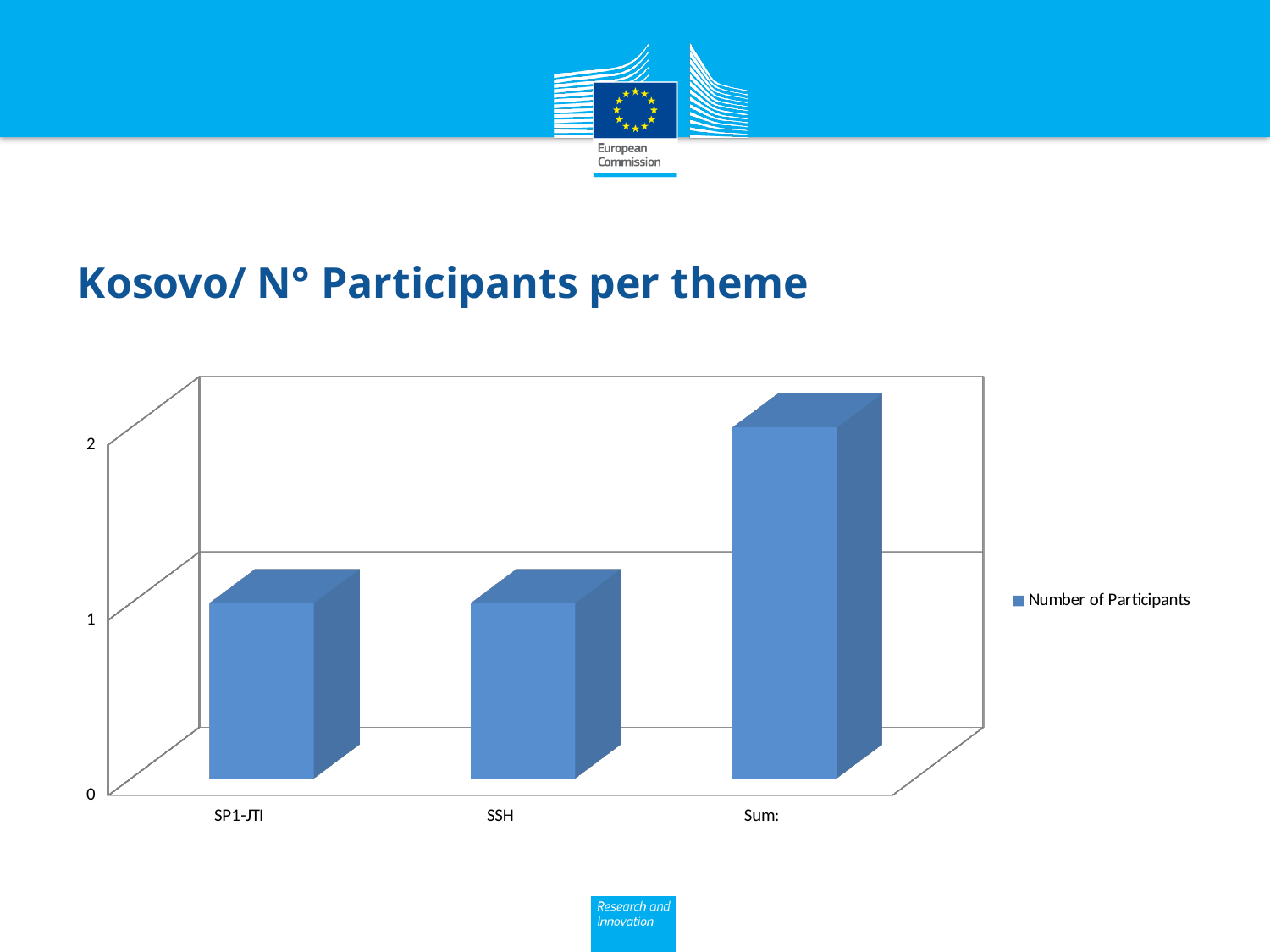
What type of chart is shown on the slide? bar chart What is the value shown for Sum:? 2 How many categories are shown on the x axis of the chart? 3 How many series does the legend list? 1 What is the number of participants for SP1-JTI? 1 What series name is shown in the legend? Number of Participants What is the title of the chart on the slide? Kosovo/ N° Participants per theme Which is larger, the value for Sum: or the value for SSH? Sum: Which category has the highest bar? Sum: What is the number of participants for SSH? 1 What is the difference between the value for Sum: and the value for SP1-JTI? 1 Is the value for Sum: greater or less than 1? greater